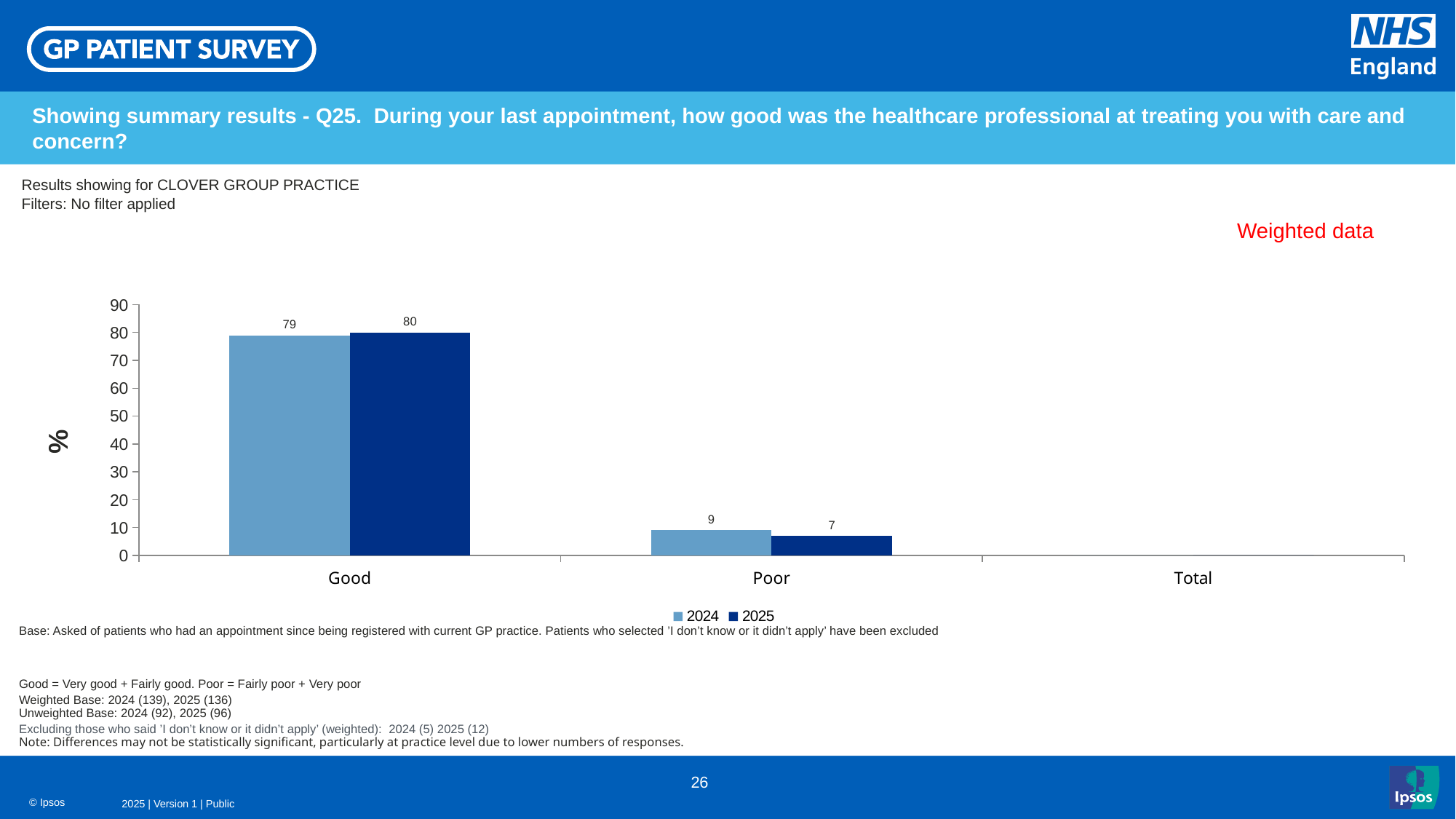
How many series does the legend list? 2 What is the difference between the Good values for 2025 and 2024? 1 Which is larger, the Poor value for 2024 or for 2025? 2024 What is the difference between the Poor values for 2024 and 2025? 2 What is the value for Good in 2024? 79 Is the value for Good in 2024 greater or less than 70? greater Which category has the highest value for 2025? Good What is the value for Good in 2025? 80 What kind of chart is shown on the slide? Bar chart What is the label on the vertical axis? % What is the value for Poor in 2024? 9 What is the value for Poor in 2025? 7